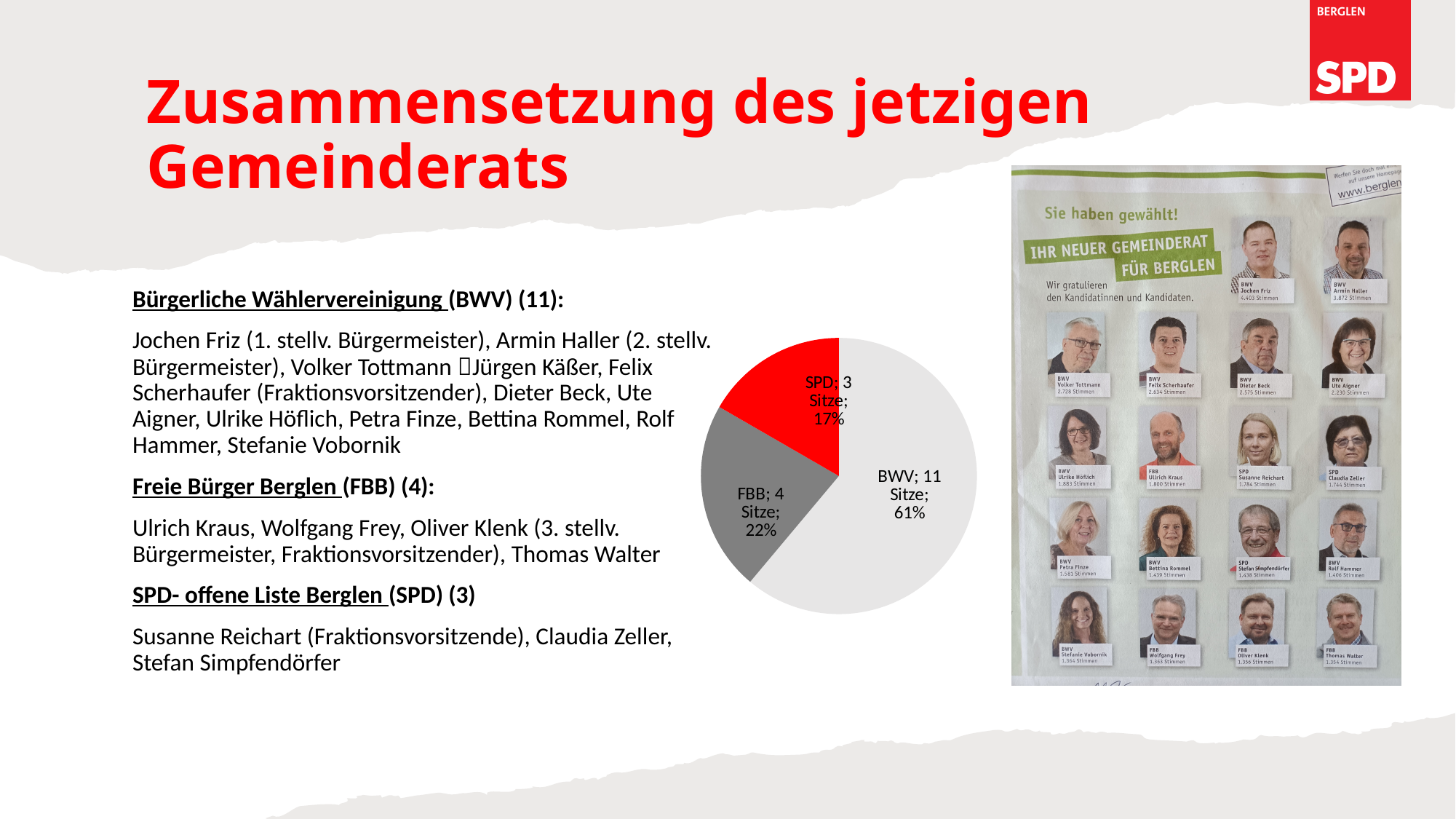
Which party has the largest slice in the pie chart? BWV How many more seats does BWV have than FBB in the pie chart? 7 Which has more seats in the pie chart, FBB or SPD? FBB How many seats (Sitze) does FBB have according to the pie chart? 4 How many seats (Sitze) does SPD have according to the pie chart? 3 How many seats (Sitze) does BWV have according to the pie chart? 11 What share of the pie chart does SPD hold? 17% What share of the pie chart does FBB hold? 22% How many slices does the pie chart have? 3 Which party has the smallest slice in the pie chart? SPD What share of the pie chart does BWV hold? 61% What kind of chart is shown on the slide? pie chart